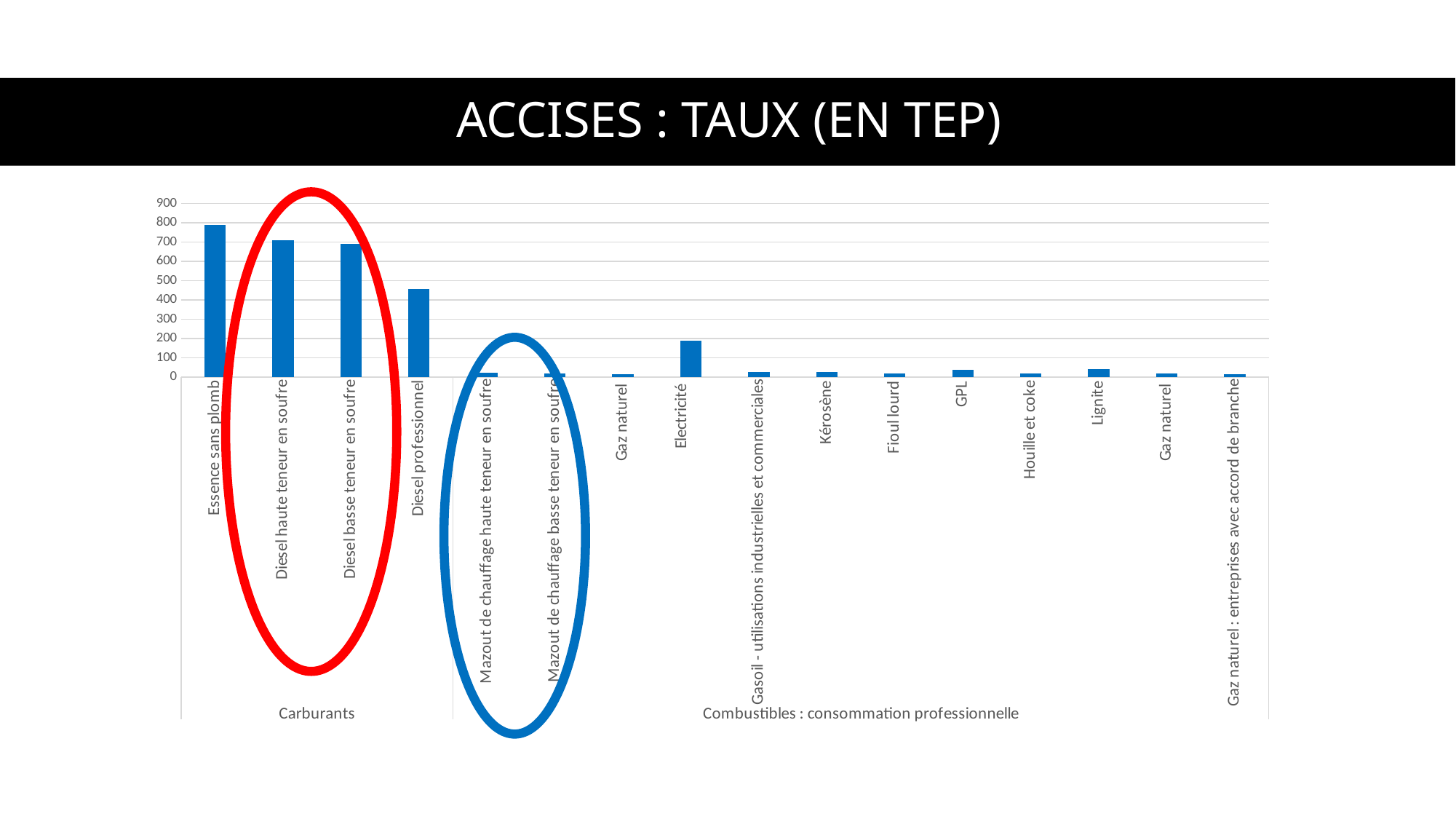
Is the value for Essence sans plomb greater or less than 700? greater Is the value for Electricité greater or less than 200? less What kind of chart is shown on the slide? bar chart What is the title of the slide? ACCISES : TAUX (EN TEP) How many categories are plotted on the chart? 16 Is the value for Diesel professionnel greater or less than 500? less What are the two group labels shown beneath the category axis? Carburants; Combustibles : consommation professionnelle Which is larger, the value for Essence sans plomb or the value for Diesel basse teneur en soufre? Essence sans plomb Which is larger, the value for Diesel professionnel or the value for Electricité? Diesel professionnel Which category has the highest value? Essence sans plomb